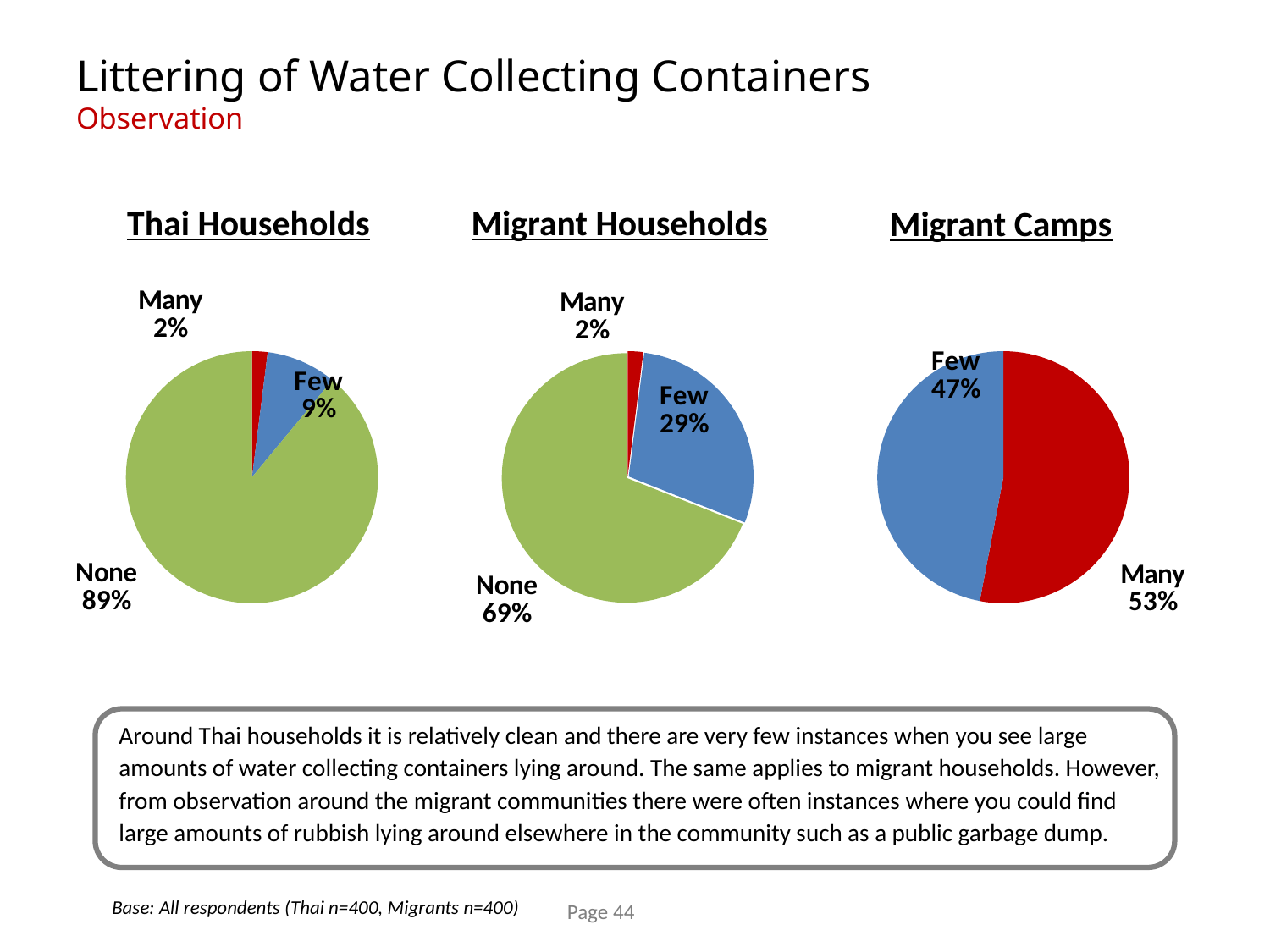
In the Migrant Households chart, which slice is the smallest? Many What type of chart is used for the Migrant Households data? Pie chart What is the difference between the None share in the Thai Households chart and the None share in the Migrant Households chart? 20% In the Migrant Households chart, what is the difference between the Few share and the Many share? 27% In the Migrant Camps chart, which slice is larger, Few or Many? Many In the Migrant Households chart, what share of the pie is labelled Few? 29% How many slices does the Thai Households chart have? 3 In the Thai Households chart, which slice is the largest? None How many pie charts are shown on the slide? 3 In the Thai Households chart, what share of the pie is labelled None? 89% In the Migrant Camps chart, what share of the pie is labelled Many? 53% How many slices does the Migrant Camps chart have? 2